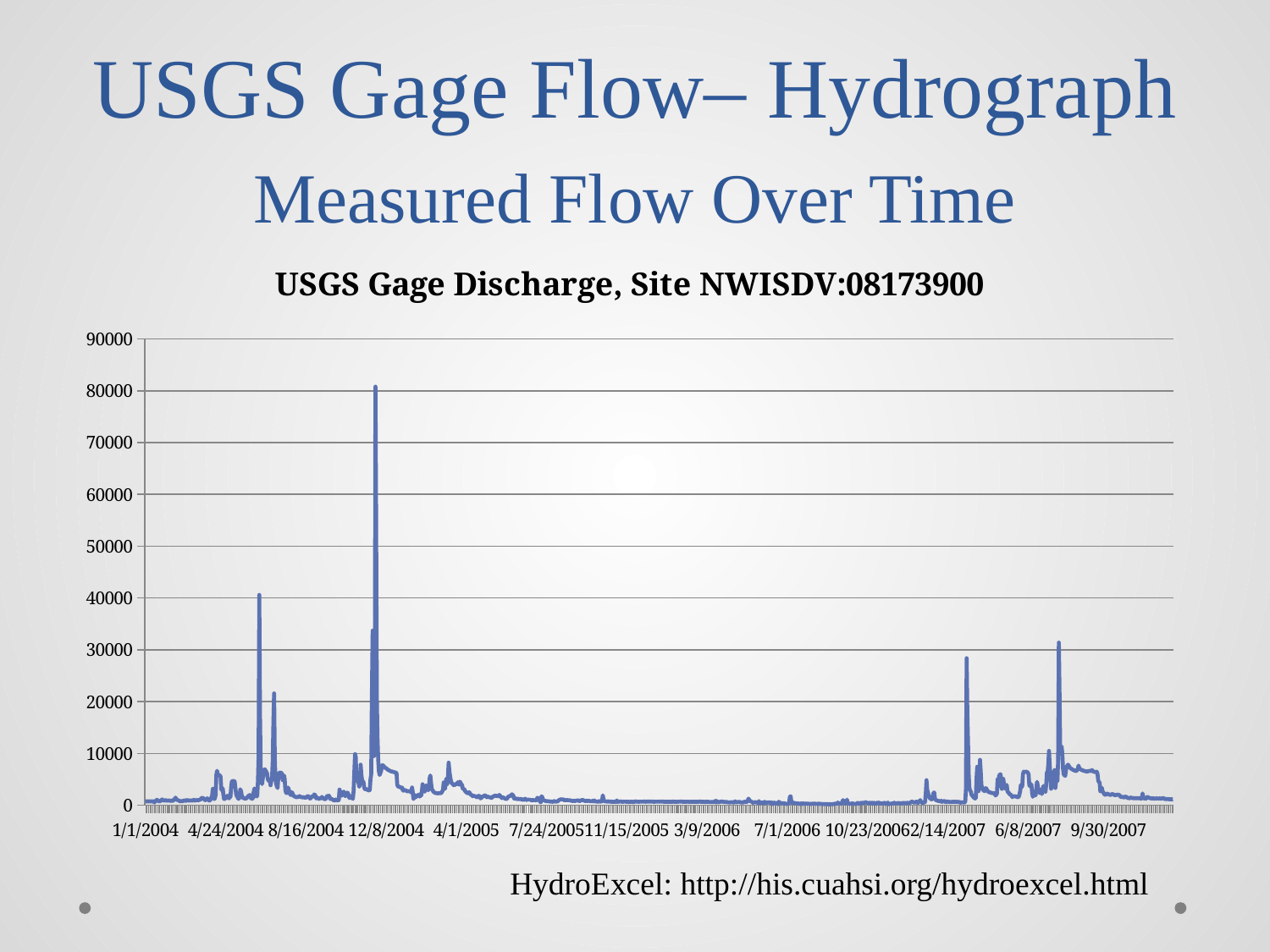
Is the highest peak of the discharge line greater or less than 90000? less What is the highest value labelled on the vertical axis of the chart? 90000 What is the last date label on the horizontal axis? 9/30/2007 What kind of chart is shown on the slide? line chart Is the discharge between 3/9/2006 and 7/1/2006 greater or less than 10000? less Is the peak that occurs between 6/8/2007 and 9/30/2007 greater or less than 20000? greater What is the title of the chart? USGS Gage Discharge, Site NWISDV:08173900 What is the first date label on the horizontal axis? 1/1/2004 How many data series (lines) are plotted on the chart? 1